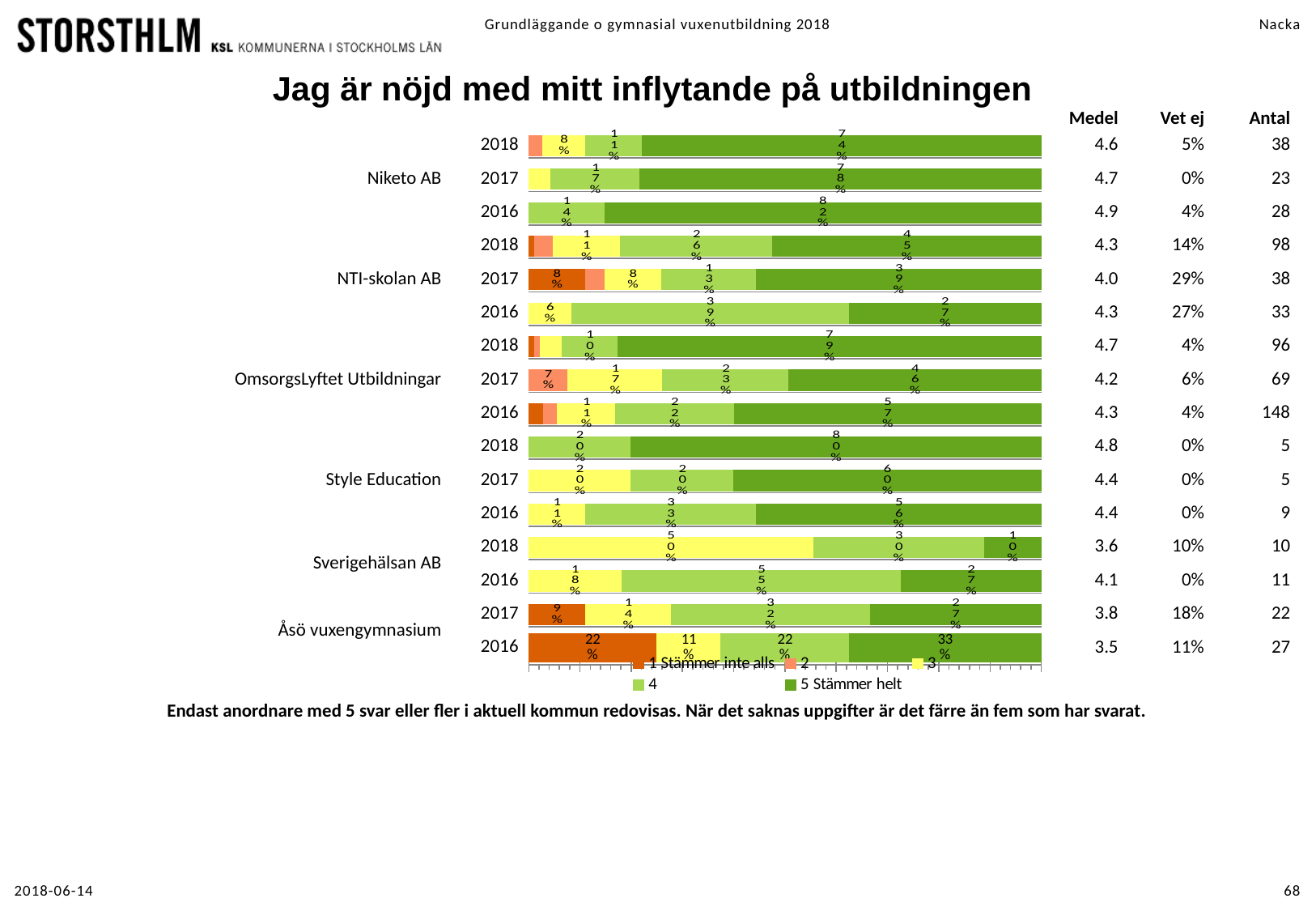
What percentage of Åsö vuxengymnasium respondents in 2016 answered '5 Stämmer helt'? 33% Which provider and year has the lowest Medel value? Åsö vuxengymnasium 2016 (3.5) What is the title of the chart? Jag är nöjd med mitt inflytande på utbildningen Which has a higher Vet ej share: NTI-skolan AB 2017 or OmsorgsLyftet Utbildningar 2017? NTI-skolan AB 2017 What is the difference in Antal between NTI-skolan AB 2018 and NTI-skolan AB 2017? 60 What kind of chart is shown on the slide? Stacked bar chart What is the Antal for OmsorgsLyftet Utbildningar in 2016? 148 What is the Medel value for Niketo AB in 2016? 4.9 How many series does the legend list? 5 Which provider and year has the highest Medel value? Niketo AB 2016 (4.9) What percentage of Style Education respondents in 2018 answered '5 Stämmer helt'? 80% What percentage of Sverigehälsan AB respondents in 2018 answered '3'? 50%